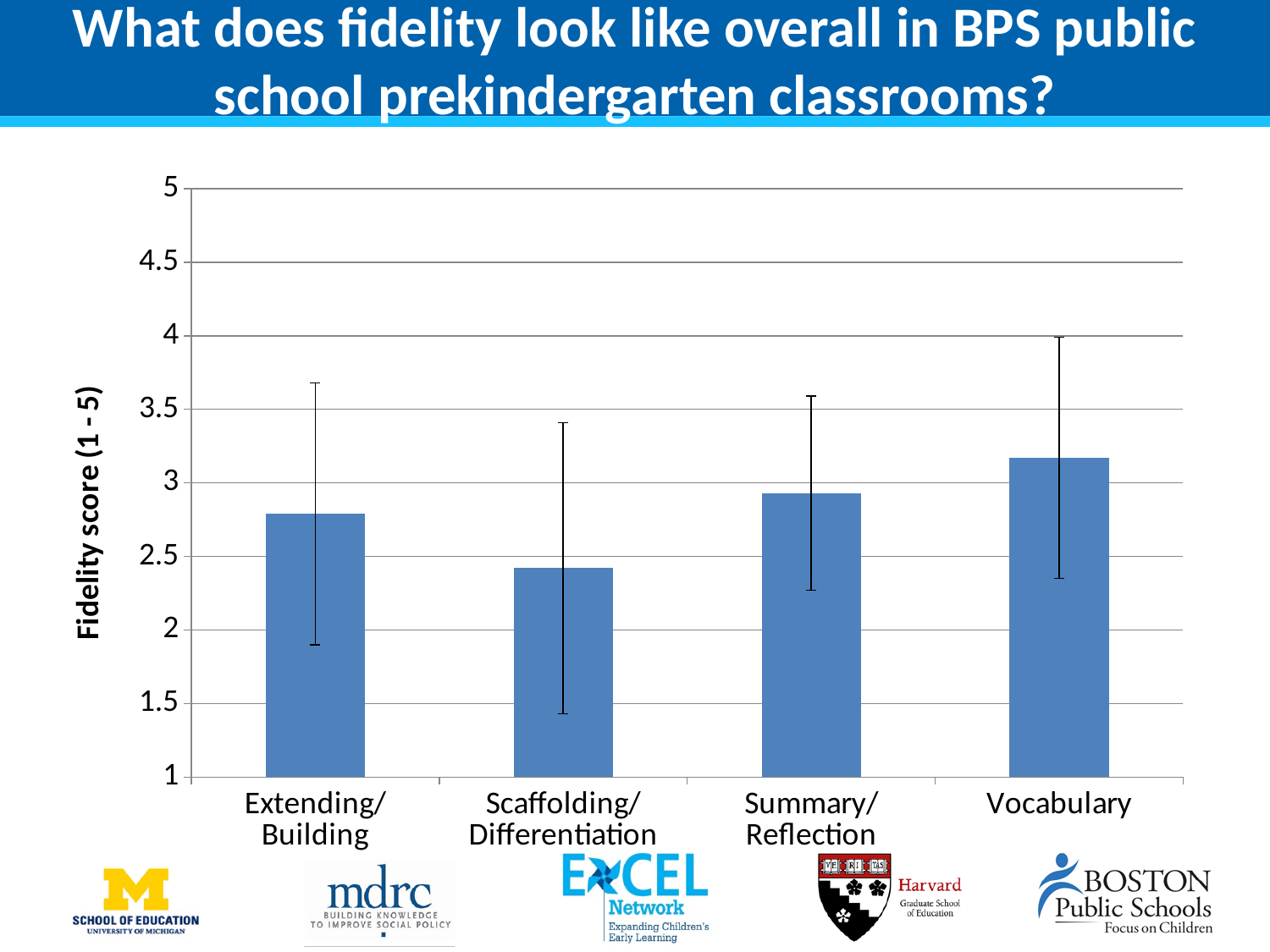
What kind of chart is shown on the slide? bar chart Is the fidelity score for Scaffolding/Differentiation greater or less than 2.5? less Is the fidelity score for Summary/Reflection greater or less than 2.5? greater Which has a higher fidelity score, Extending/Building or Scaffolding/Differentiation? Extending/Building Is the fidelity score for Vocabulary greater or less than 3? greater Which category has the lowest fidelity score? Scaffolding/Differentiation Which has a higher fidelity score, Summary/Reflection or Vocabulary? Vocabulary What is the maximum value shown on the y axis of the chart? 5 How many categories are plotted on the x axis of the chart? 4 What is the label of the y axis of the chart? Fidelity score (1 - 5) Which category has the highest fidelity score? Vocabulary